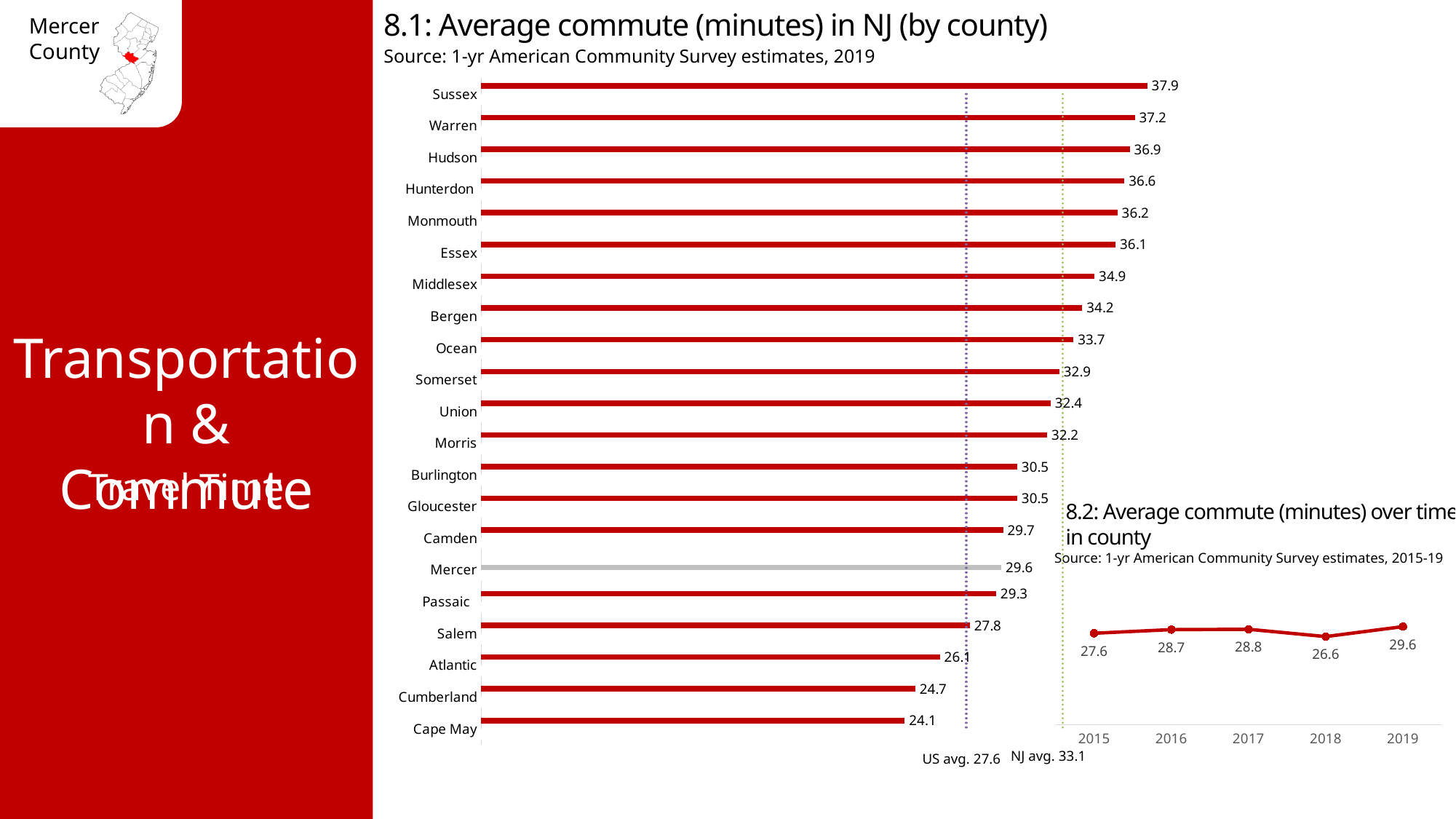
In chart 8.1 (Average commute in NJ by county), what is the average commute for Cumberland County? 24.7 In chart 8.2 (Average commute over time in county), what was the average commute in 2018? 26.6 In chart 8.1 (Average commute in NJ by county), what is the difference between Sussex's and Cape May's average commute? 13.8 What type of chart is chart 8.2 (Average commute over time in county)? Line chart In chart 8.1 (Average commute in NJ by county), how many counties are shown? 21 In chart 8.1 (Average commute in NJ by county), what NJ average value is marked by the dotted reference line? 33.1 In chart 8.2 (Average commute over time in county), what is the difference between the 2019 and 2015 values? 2.0 In chart 8.1 (Average commute in NJ by county), which county has a longer average commute, Hudson or Bergen? Hudson In chart 8.1 (Average commute in NJ by county), what is the average commute for Mercer County? 29.6 In chart 8.1 (Average commute in NJ by county), which county has the lowest average commute? Cape May In chart 8.1 (Average commute in NJ by county), which county has the highest average commute? Sussex In chart 8.2 (Average commute over time in county), which year had the highest average commute? 2019